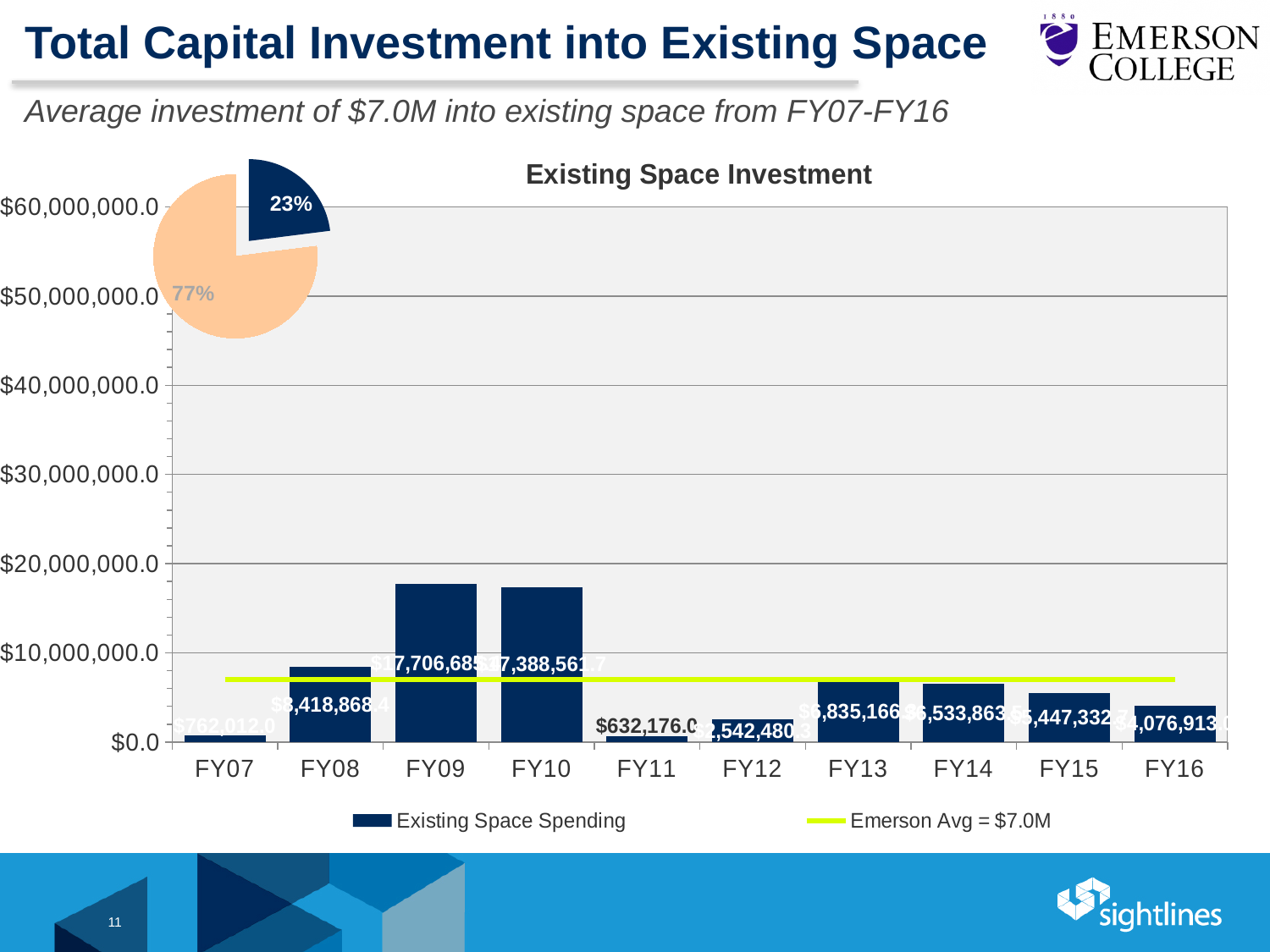
In the pie chart at the top left of the slide, what percentage is shown for the larger slice? 77% In the pie chart at the top left of the slide, what percentage is shown for the dark blue slice? 23% In the 'Existing Space Investment' chart, which has the larger Existing Space Spending, FY13 or FY16? FY13 How many entries does the legend of the 'Existing Space Investment' chart list? 2 In the 'Existing Space Investment' chart, which has the larger Existing Space Spending, FY08 or FY12? FY08 In the 'Existing Space Investment' bar chart, how many fiscal years are shown on the x axis? 10 In the 'Existing Space Investment' chart, is the value for FY09 greater or less than $10,000,000.0? greater In the 'Existing Space Investment' chart, what value does the legend give for the Emerson Avg line? $7.0M In the 'Existing Space Investment' chart, do the bars rise or fall from FY13 to FY16? fall In the 'Existing Space Investment' chart, is the value for FY12 greater or less than $10,000,000.0? less What type of chart is the 'Existing Space Investment' chart? bar chart In the 'Existing Space Investment' chart, what is the value of Existing Space Spending for FY10? $17,388,561.7